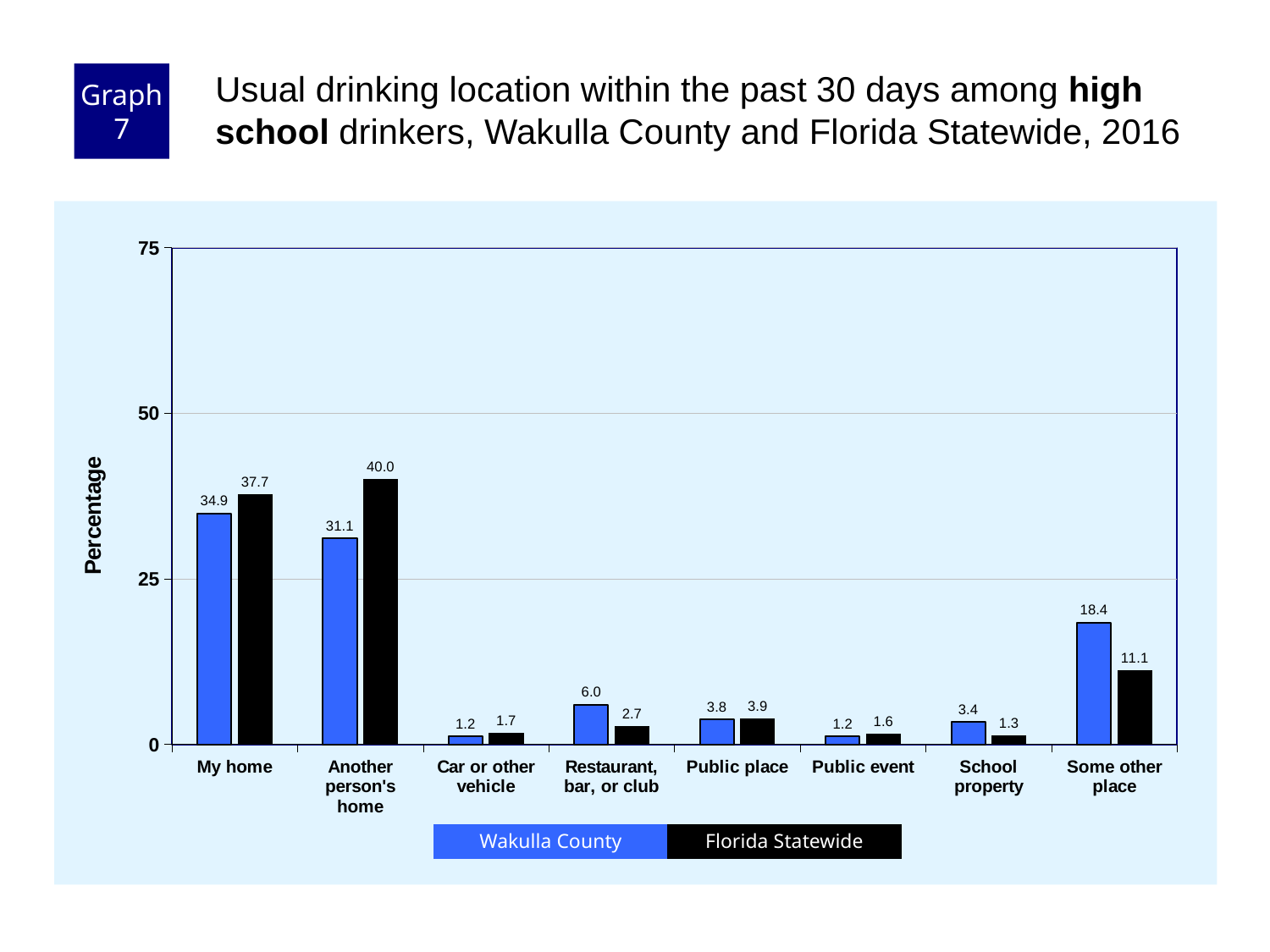
What is the difference between the Wakulla County and Florida Statewide values for Some other place? 7.3 How many series does the legend list? 2 What is the Florida Statewide value for Another person's home? 40.0 Which category has the highest Florida Statewide value? Another person's home Which category has the highest Wakulla County value? My home How many categories are shown on the x axis? 8 Is the Florida Statewide value for Another person's home greater or less than 25? greater What is the Wakulla County value for Some other place? 18.4 Which is larger for Restaurant, bar, or club: Wakulla County or Florida Statewide? Wakulla County What is the Wakulla County value for My home? 34.9 What is the difference between the Florida Statewide and Wakulla County values for My home? 2.8 What kind of chart is shown? bar chart